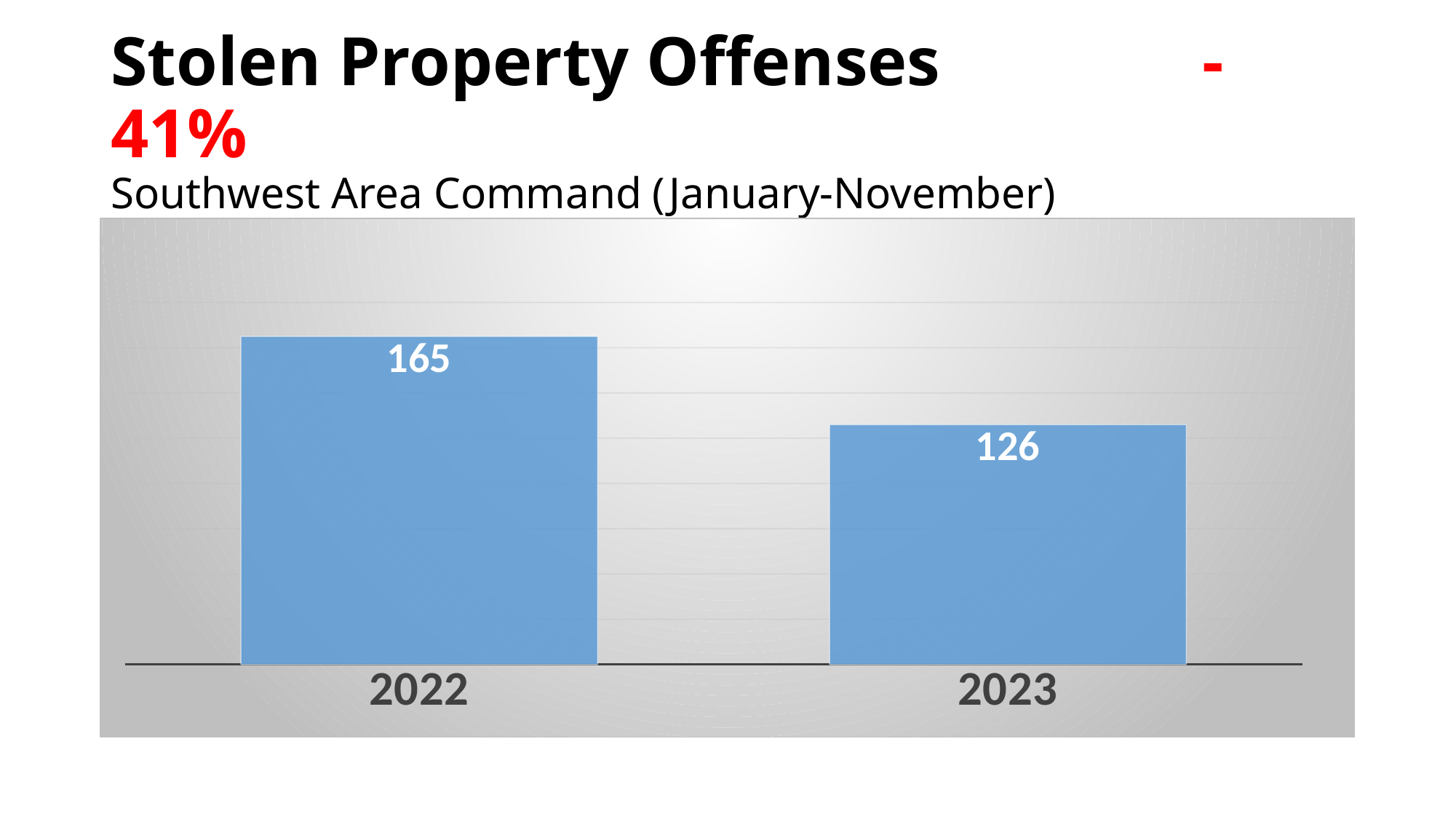
What is the difference between the 2022 and 2023 values? 39 How many categories are shown on the x axis? 2 Which year has the highest value? 2022 Which is larger, the value for 2022 or the value for 2023? 2022 What percentage change is shown in red next to the title? -41% Which area command and period does the subtitle say the chart covers? Southwest Area Command (January-November) What kind of chart is shown on the slide? bar chart Which year has the lowest value? 2023 What is the value for 2022? 165 What is the value for 2023? 126 Do the values rise or fall from 2022 to 2023? fall